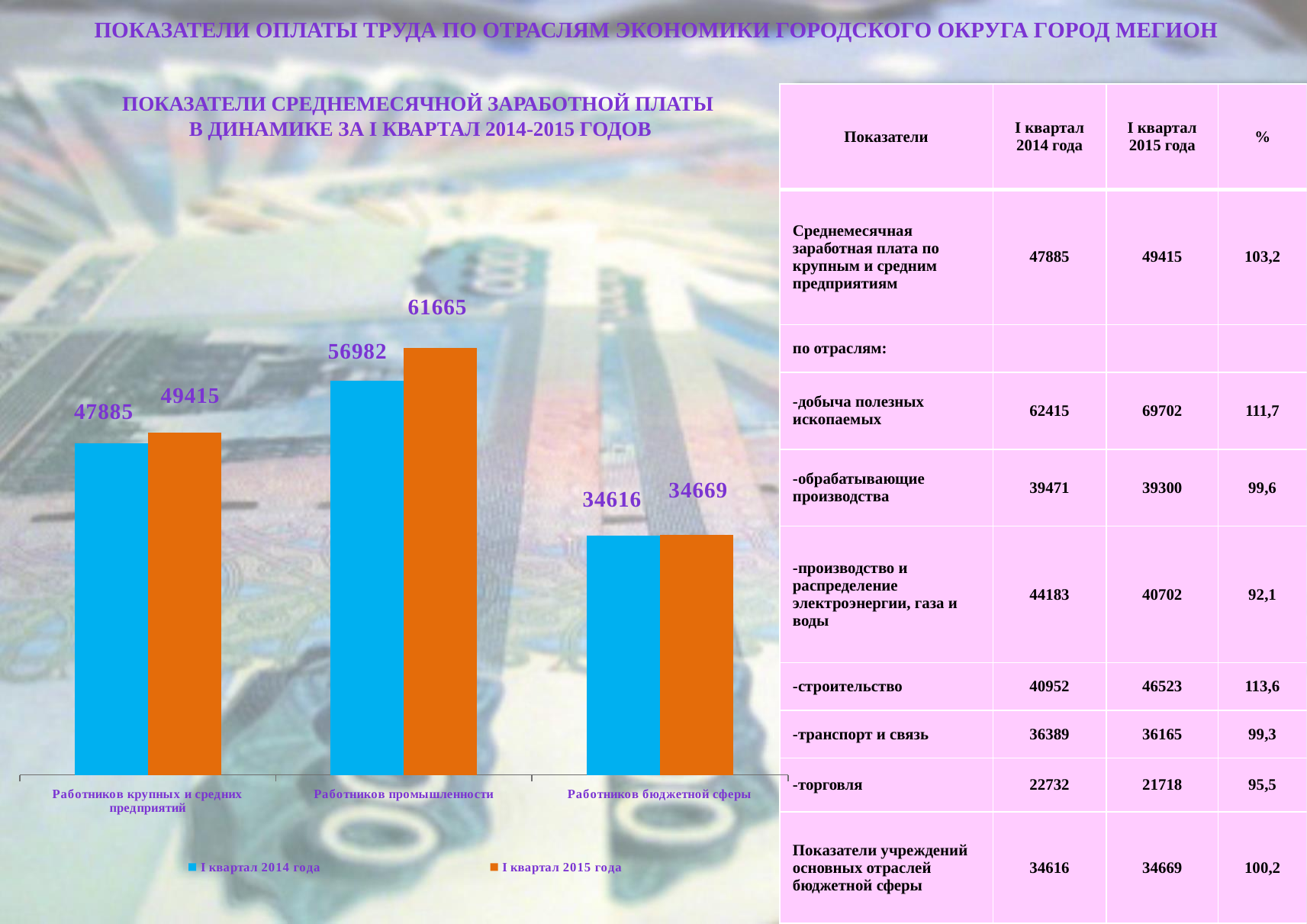
What is the value for Работников бюджетной сферы in the I квартал 2015 года series? 34669 What is the difference between the I квартал 2015 года and I квартал 2014 года values for Работников крупных и средних предприятий? 1530 What is the difference between the I квартал 2015 года and I квартал 2014 года values for Работников промышленности? 4683 Which colour represents the I квартал 2015 года series in the chart? orange What is the value for Работников промышленности in the I квартал 2015 года series? 61665 For Работников промышленности, which series has the larger value: I квартал 2014 года or I квартал 2015 года? I квартал 2015 года How many series does the chart legend list? 2 What kind of chart is shown on the slide? bar chart What is the value for Работников крупных и средних предприятий in the I квартал 2014 года series? 47885 Which category has the highest value in the I квартал 2015 года series? Работников промышленности How many categories are shown on the x axis of the chart? 3 Which category has the lowest value in the I квартал 2014 года series? Работников бюджетной сферы